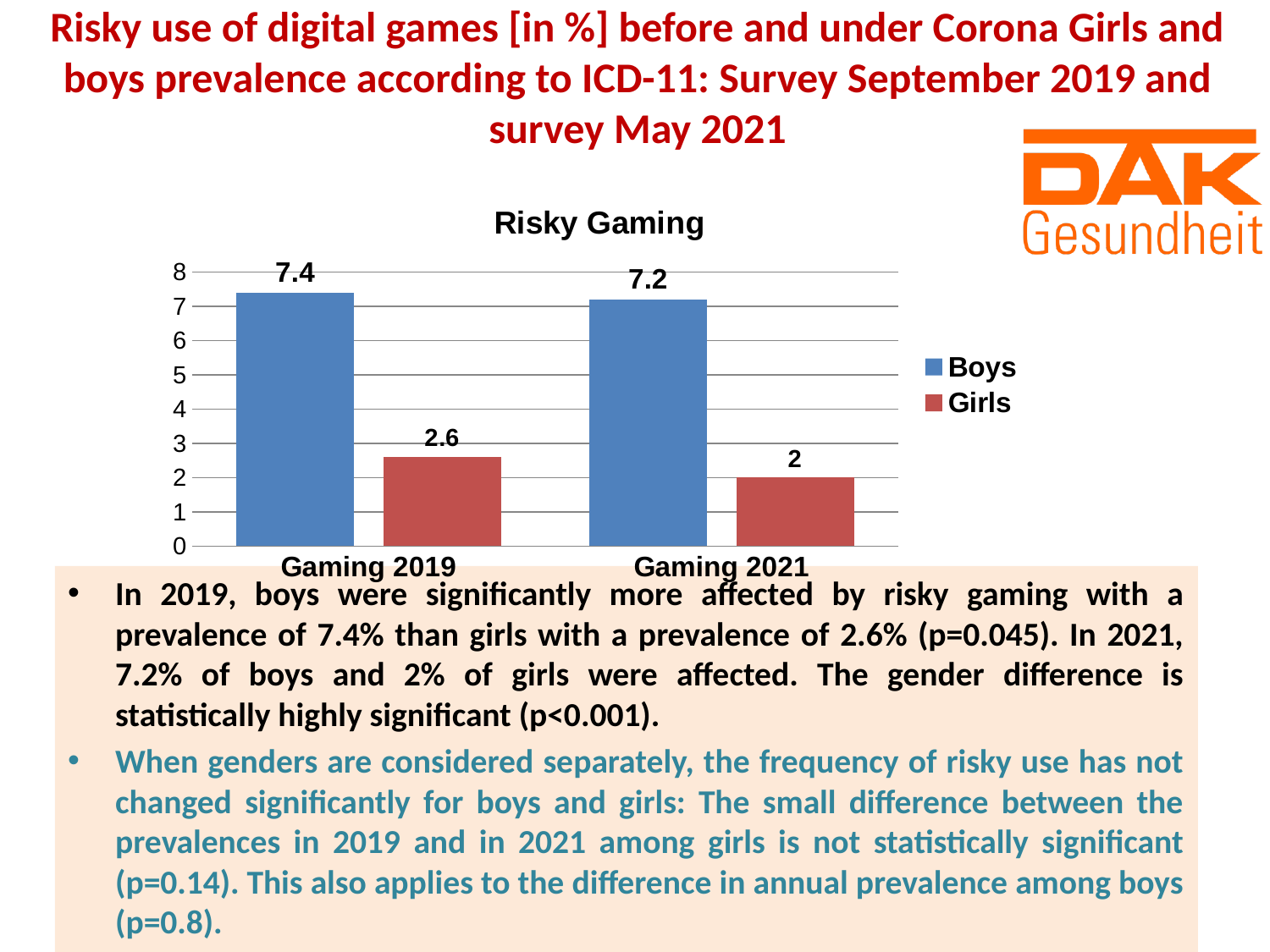
How many series does the legend list? 2 Which bar has the lowest value in the chart? Girls, Gaming 2021 Which bar has the highest value in the chart? Boys, Gaming 2019 What is the value for Boys in Gaming 2021? 7.2 Which is larger, the Boys value in Gaming 2019 or the Boys value in Gaming 2021? Gaming 2019 What is the difference between the Boys and Girls values in Gaming 2019? 4.8 What kind of chart is shown? Bar chart What is the value for Girls in Gaming 2021? 2 What is the value for Boys in Gaming 2019? 7.4 What is the title of the chart? Risky Gaming What is the value for Girls in Gaming 2019? 2.6 What is the difference between the Girls values in Gaming 2019 and Gaming 2021? 0.6